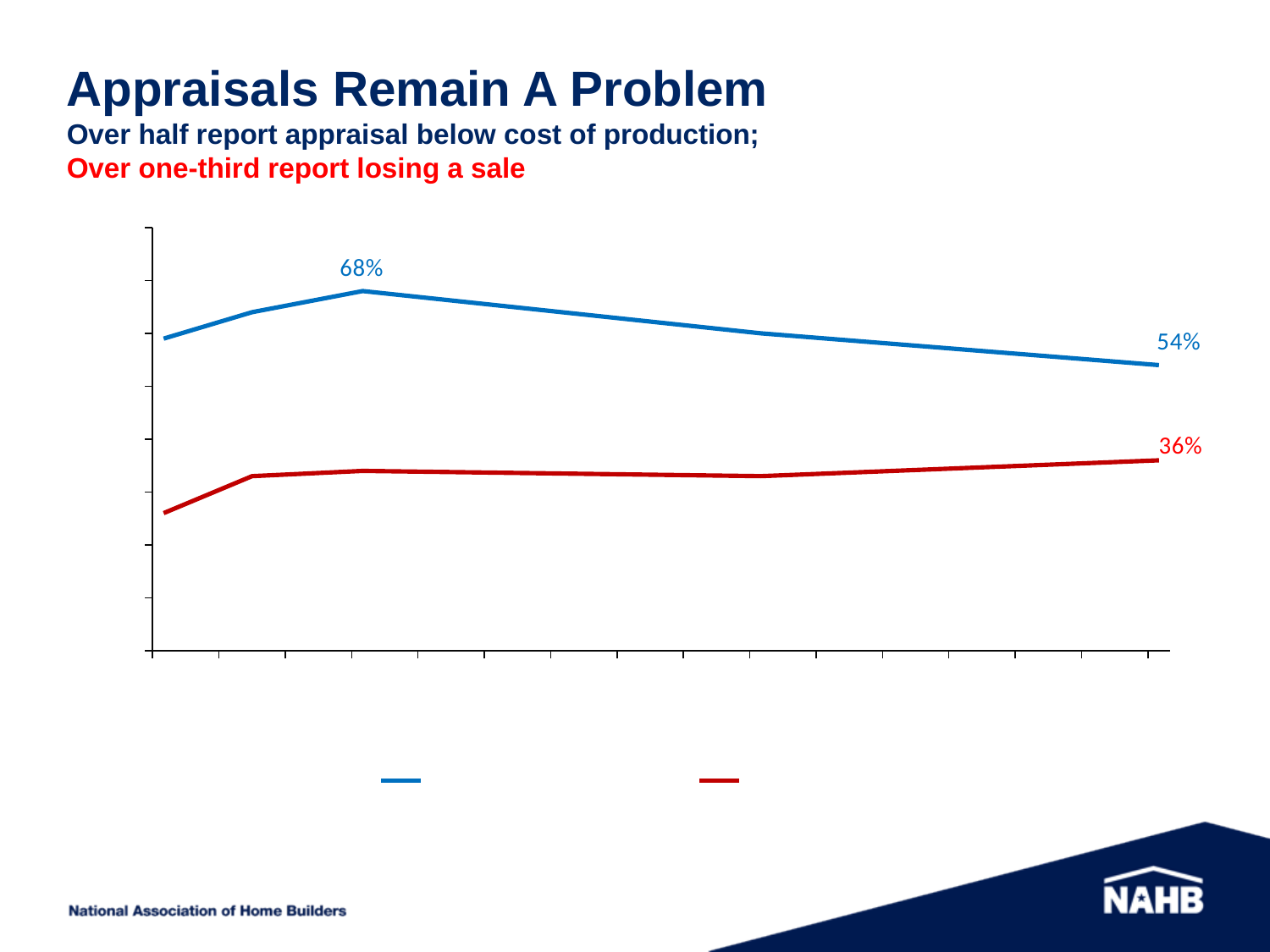
At the right end of the chart, which line has the larger value, the blue line or the red line? the blue line What kind of chart is shown on the slide? line chart What is the highest value labeled on the blue line? 68% What is the value labeled at the right end of the blue line? 54% After reaching its peak of 68%, does the blue line rise or fall toward the right end of the chart? fall What is the value labeled at the right end of the red line? 36% By how much did the blue line fall from its labeled peak of 68% to its final labeled value of 54%? 14 percentage points How many series does the legend list? 2 What is the title of the slide containing the chart? Appraisals Remain A Problem What is the difference between the blue line's final value (54%) and the red line's final value (36%)? 18 percentage points Which line is higher across the whole chart, the blue line or the red line? the blue line What is the lowest value labeled on the chart? 36%